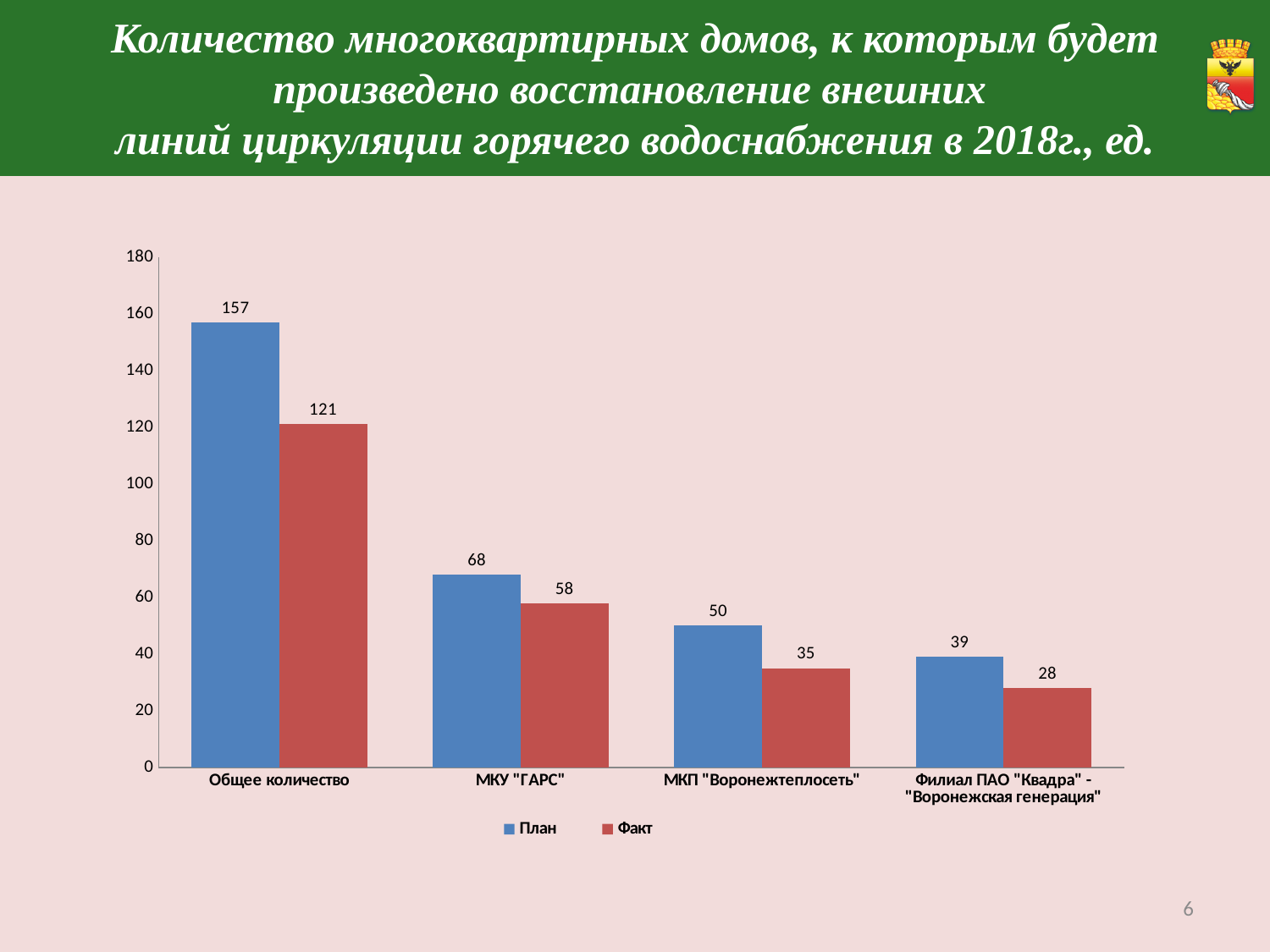
Which category has the lowest Факт value? Филиал ПАО "Квадра" - "Воронежская генерация" How many series does the legend list? 2 What is the difference between the План and Факт values for Общее количество? 36 Which is larger: the Факт value for МКУ "ГАРС" or the План value for МКП "Воронежтеплосеть"? Факт value for МКУ "ГАРС" What kind of chart is shown on the slide? Bar chart Which category has the highest План value? Общее количество What is the План value for МКУ "ГАРС"? 68 How many categories are shown on the x axis? 4 What is the Факт value for МКП "Воронежтеплосеть"? 35 What is the difference between the План and Факт values for Филиал ПАО "Квадра" - "Воронежская генерация"? 11 What is the Факт value for Общее количество? 121 Which colour represents the Факт series in the legend? Red